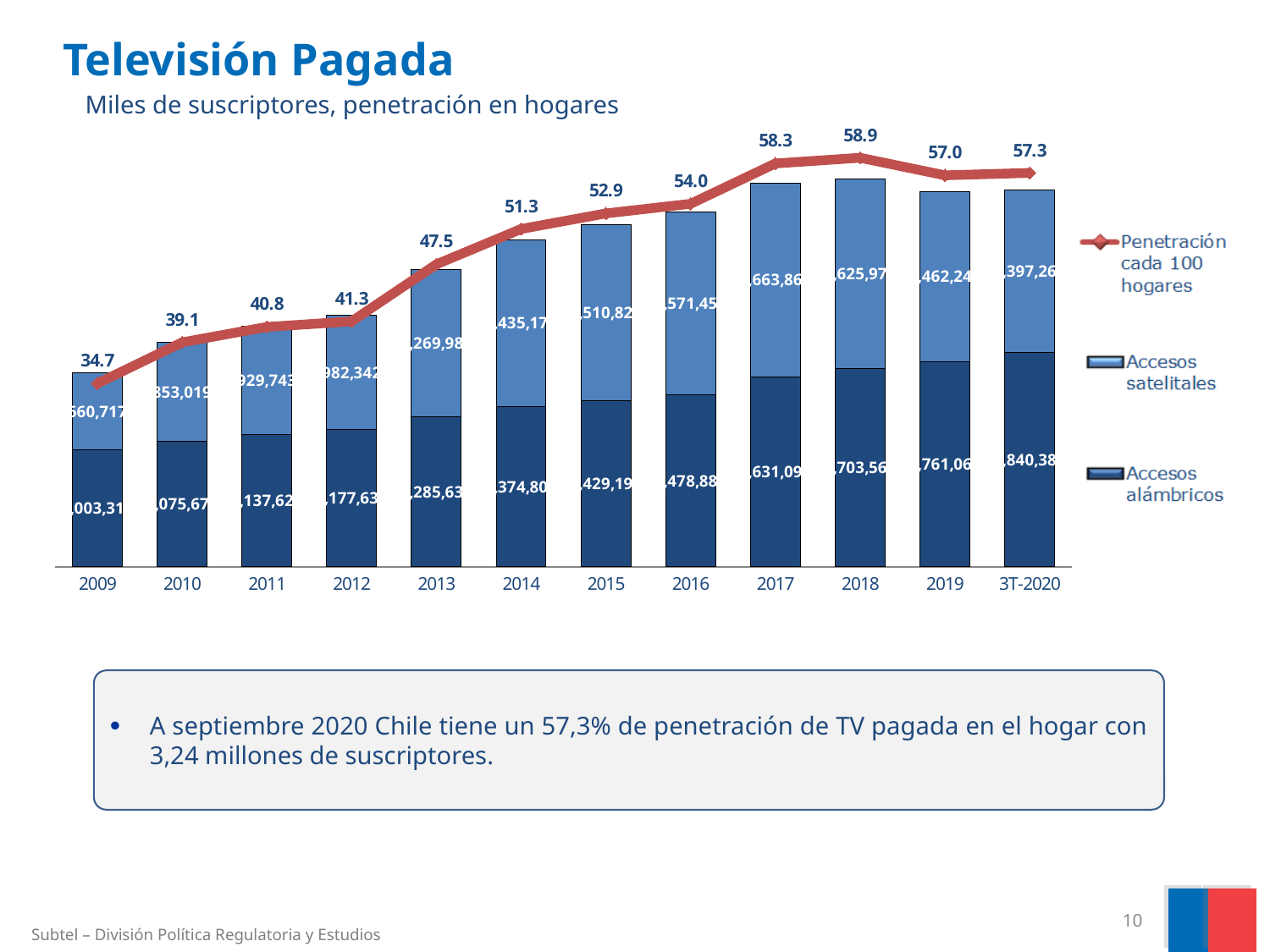
Which series is shown in the darker blue at the bottom of each bar? Accesos alámbricos How many series does the legend list? 3 How many time periods are shown on the x axis? 12 In which year does Penetración cada 100 hogares reach its highest value? 2018 What is the value of Penetración cada 100 hogares for 2014? 51.3 Which year has a higher Penetración cada 100 hogares, 2013 or 2016? 2016 What kind of chart is shown on the slide? Stacked bar chart with a line What is the value of Penetración cada 100 hogares for 2009? 34.7 Does Penetración cada 100 hogares rise or fall from 2009 to 2018? Rise In which year is Penetración cada 100 hogares lowest? 2009 What is the value of Penetración cada 100 hogares for 3T-2020? 57.3 What is the difference in Penetración cada 100 hogares between 2018 and 2019? 1.9